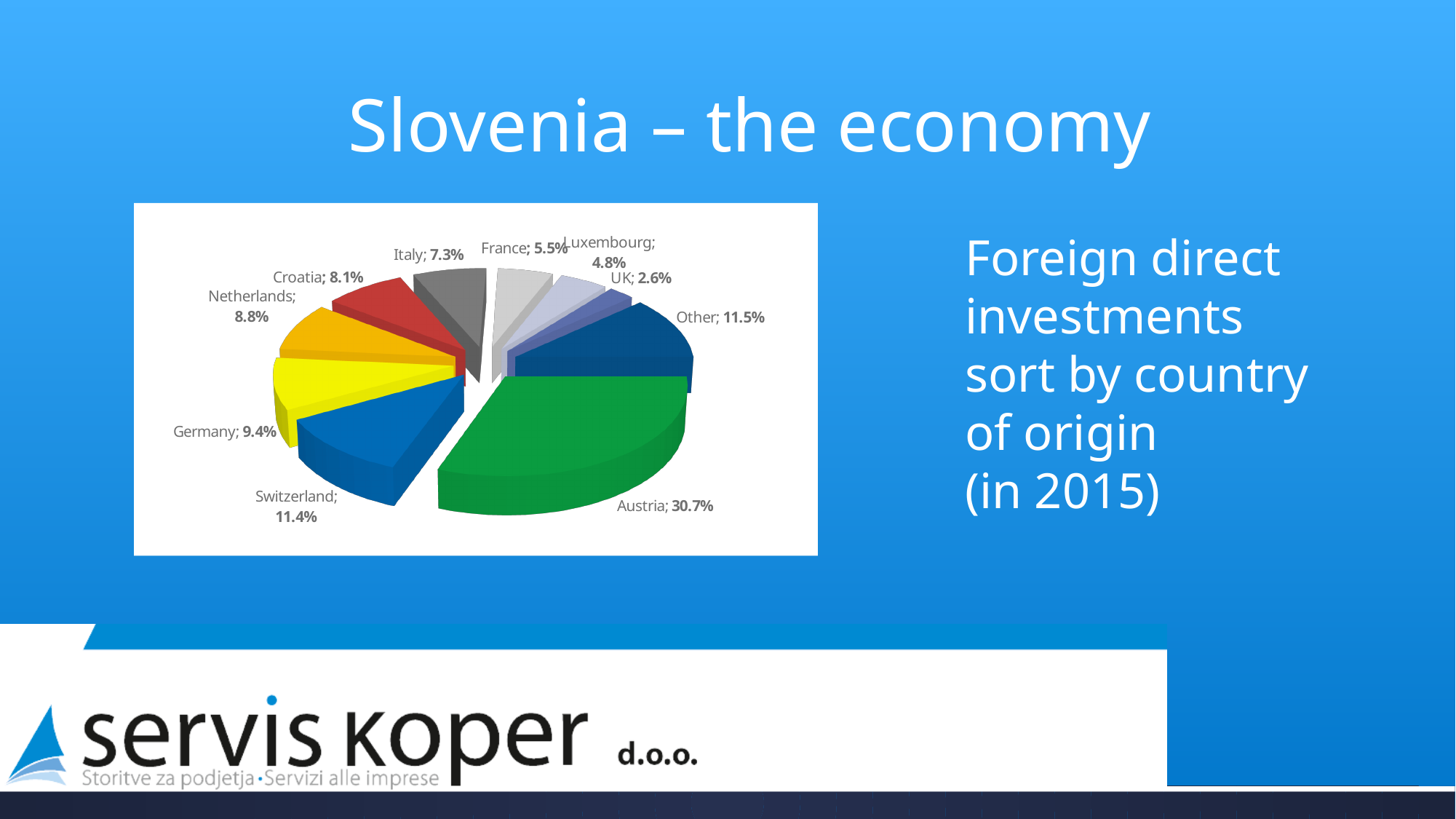
What share of foreign direct investments comes from Austria? 30.7% What kind of chart is shown on the slide? Pie chart How many slices does the pie chart have? 10 What colour is the Austria slice of the pie chart? Green Which country has the largest share of foreign direct investments? Austria Which has a larger share, Netherlands or Croatia? Netherlands Which named country has the smallest share of foreign direct investments? UK What percentage is shown for the UK? 2.6% What percentage is shown for Germany? 9.4% What percentage is shown for Luxembourg? 4.8% What is the difference in percentage points between Austria's share and Switzerland's share? 19.3 What share of foreign direct investments comes from Switzerland? 11.4%